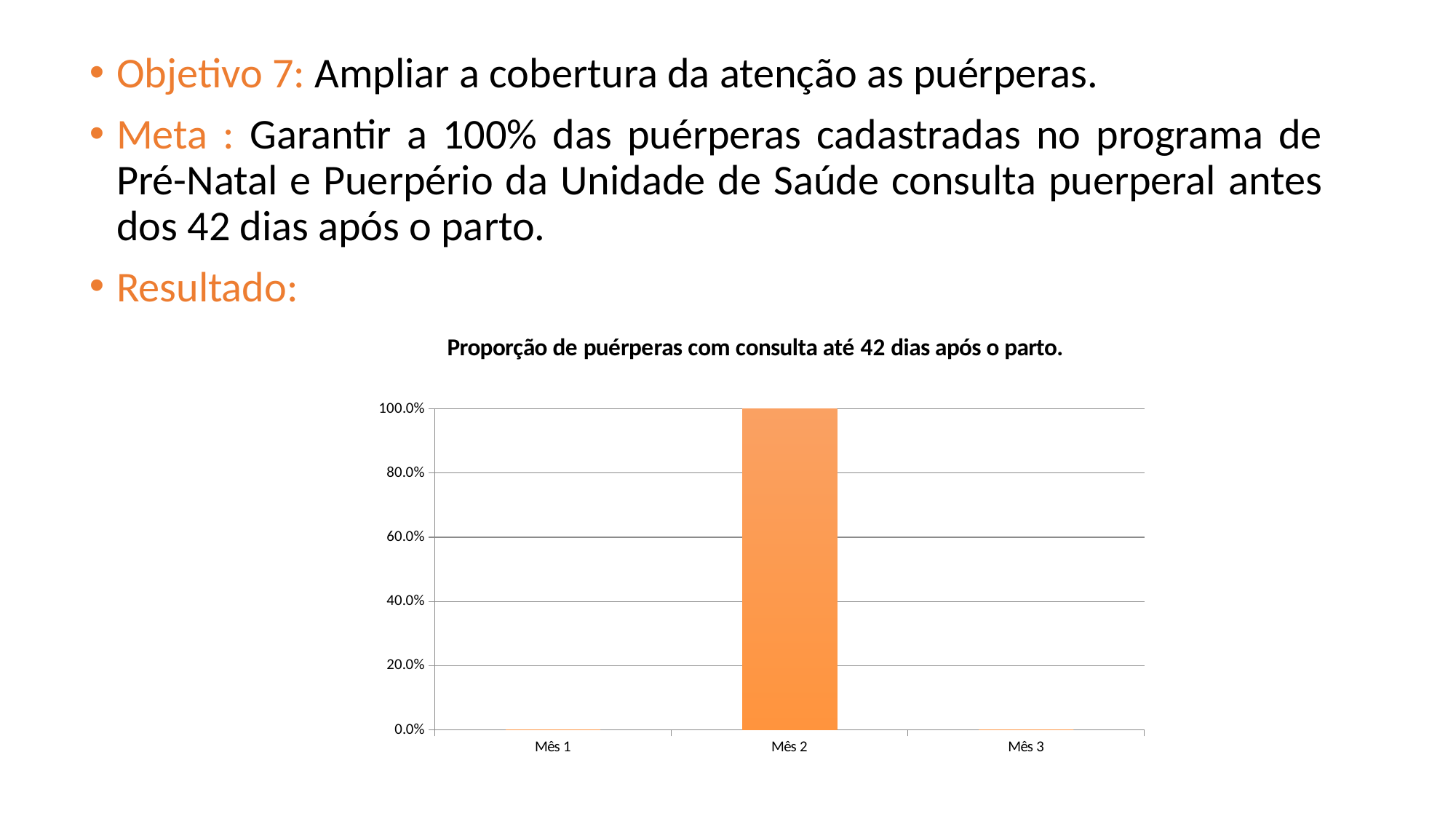
Does the value rise or fall from Mês 2 to Mês 3? fall What is the value for Mês 2 in the chart? 100.0% What is the title of the chart? Proporção de puérperas com consulta até 42 dias após o parto. Is the value for Mês 3 greater or less than 20.0%? less What type of chart is shown on the slide? bar chart Which is larger, the value for Mês 2 or the value for Mês 3? Mês 2 Which is larger, the value for Mês 1 or the value for Mês 2? Mês 2 What is the highest value shown on the y axis of the chart? 100.0% Is the value for Mês 2 greater or less than 80.0%? greater Is the value for Mês 1 greater or less than 20.0%? less How many categories are shown on the x axis of the chart? 3 Which month has the highest value in the chart? Mês 2